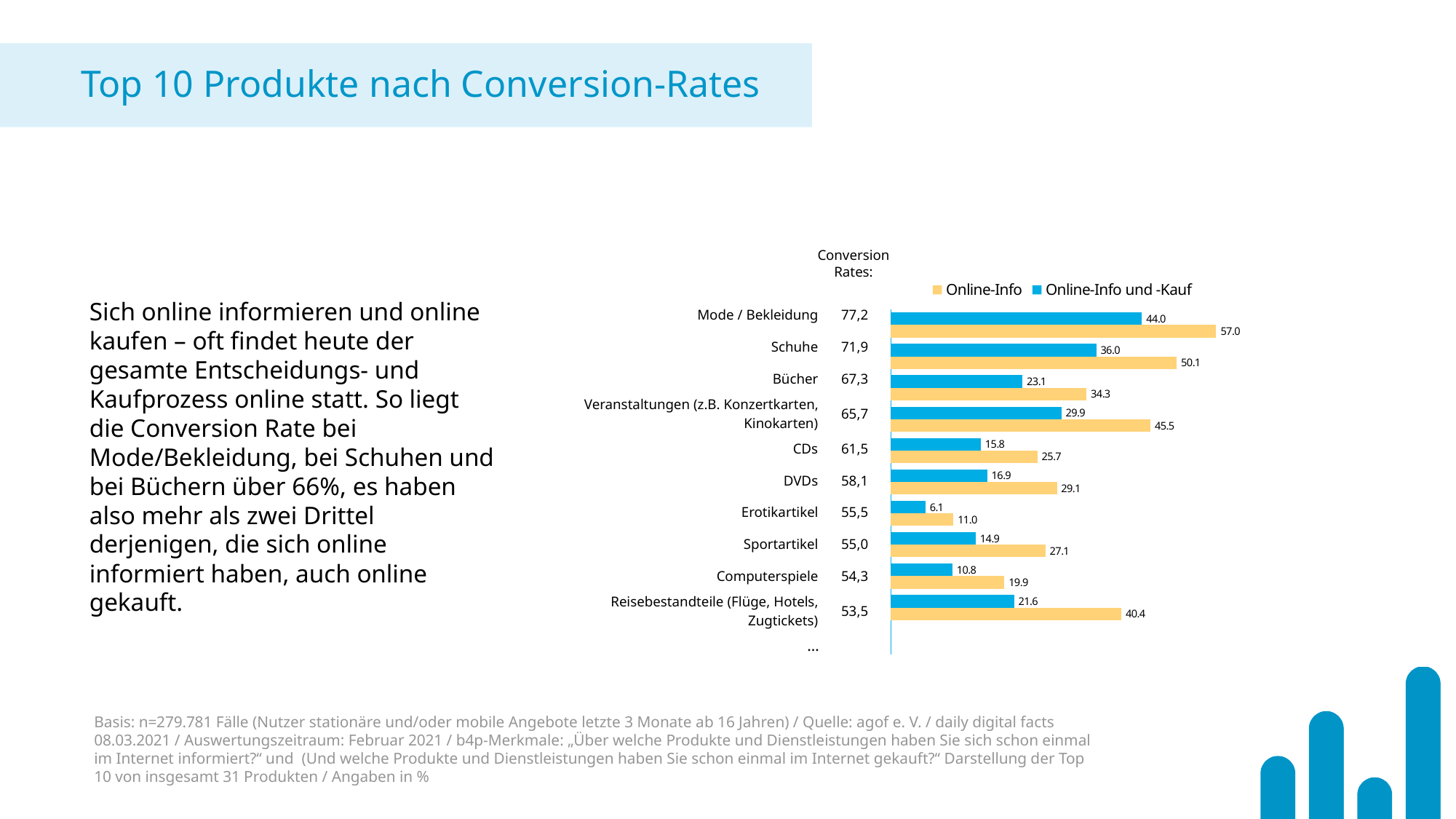
Which product has the highest Online-Info und -Kauf value? Mode / Bekleidung What is the Online-Info value for Reisebestandteile (Flüge, Hotels, Zugtickets)? 40.4 What is the Online-Info und -Kauf value for Schuhe? 36.0 What is the Online-Info value for Mode / Bekleidung? 57.0 What is the Online-Info und -Kauf value for Computerspiele? 10.8 How many named product categories are shown in the chart? 10 What kind of chart is shown on the slide? Bar chart Which is larger: the Online-Info und -Kauf value for DVDs or for CDs? DVDs What is the difference between the Online-Info and the Online-Info und -Kauf values for Bücher? 11.2 Which product has the lowest Online-Info value? Erotikartikel How many series does the legend list? 2 Which colour represents the Online-Info series in the chart? Yellow